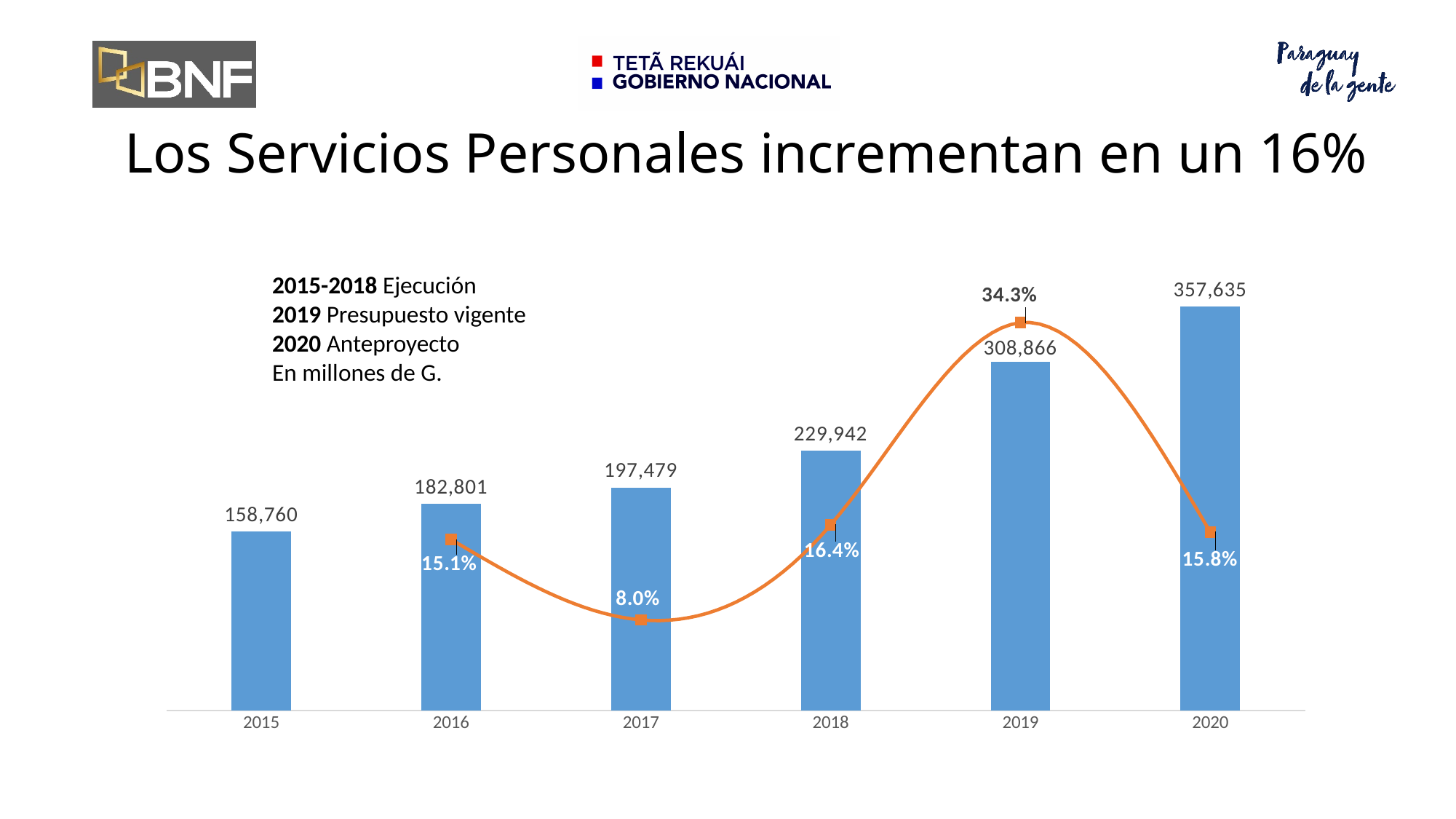
What percentage is shown on the line for 2017? 8.0% What is the value of the bar for 2015? 158,760 Which is larger, the bar value for 2017 or for 2018? 2018 What kind of chart is shown on the slide? a bar chart combined with a line chart What is the difference between the bar values for 2020 and 2019? 48,769 What is the value of the bar for 2018? 229,942 How many years are shown on the x axis? 6 According to the note on the chart, in what unit are the values expressed? millones de G. Which year has the highest bar value? 2020 Do the bar values rise or fall from 2015 to 2020? rise What percentage is shown on the line for 2019? 34.3% Which year has the lowest percentage on the line? 2017